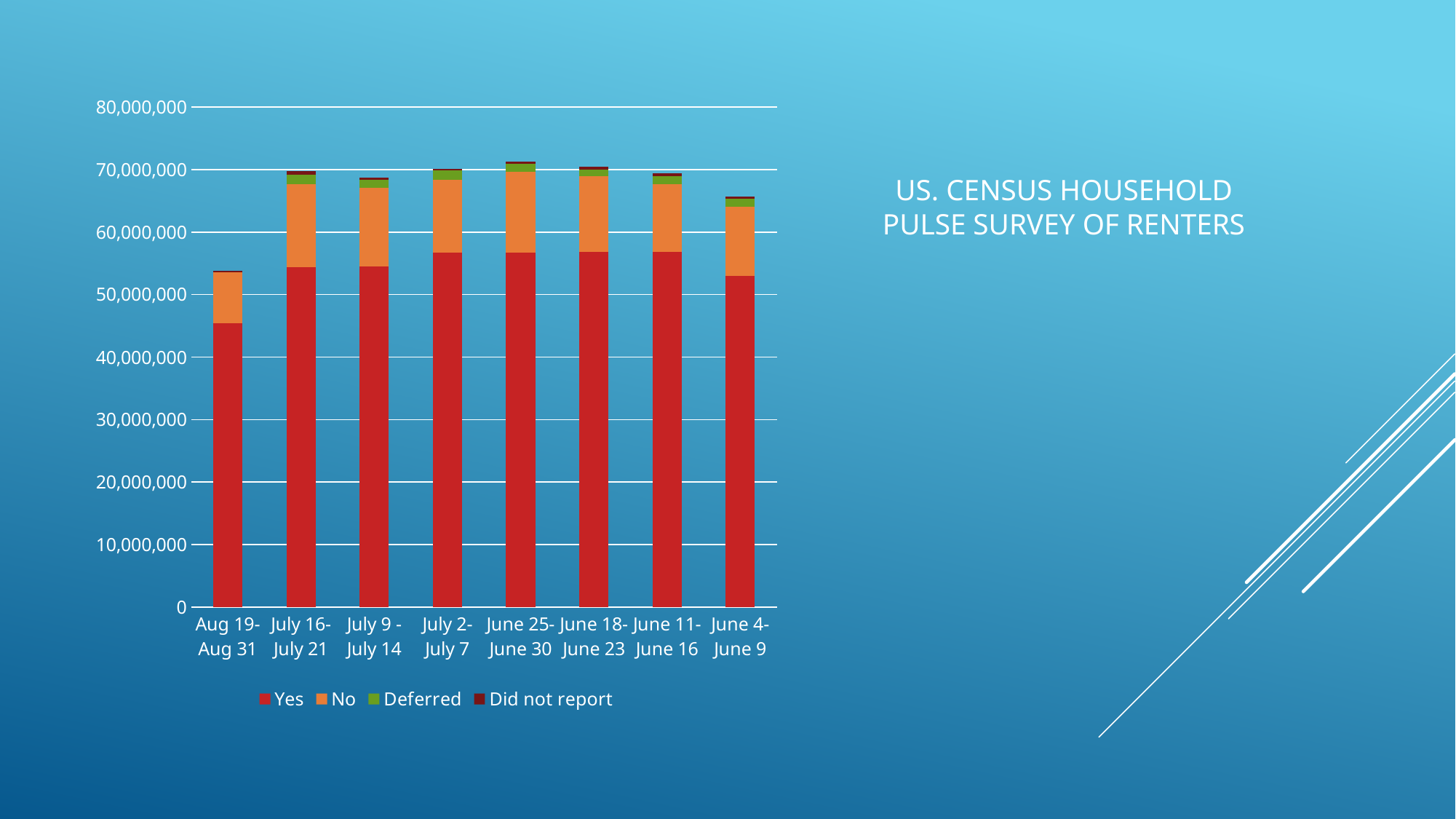
How many series does the legend list? 4 How many survey periods (categories) are shown on the x axis? 8 Which survey period has the lowest total bar height? Aug 19-Aug 31 Is the total bar height for Aug 19-Aug 31 greater or less than 60,000,000? less Which survey period has the lowest value for the Yes series? Aug 19-Aug 31 Which series is shown in orange in the legend? No Which is larger, the Yes value for Aug 19-Aug 31 or the Yes value for June 4-June 9? June 4-June 9 Is the total bar height for June 25-June 30 greater or less than 70,000,000? greater Is the Yes value for Aug 19-Aug 31 greater or less than 50,000,000? less What kind of chart is shown on the slide? Stacked bar chart What is the title shown next to the chart? US. CENSUS HOUSEHOLD PULSE SURVEY OF RENTERS